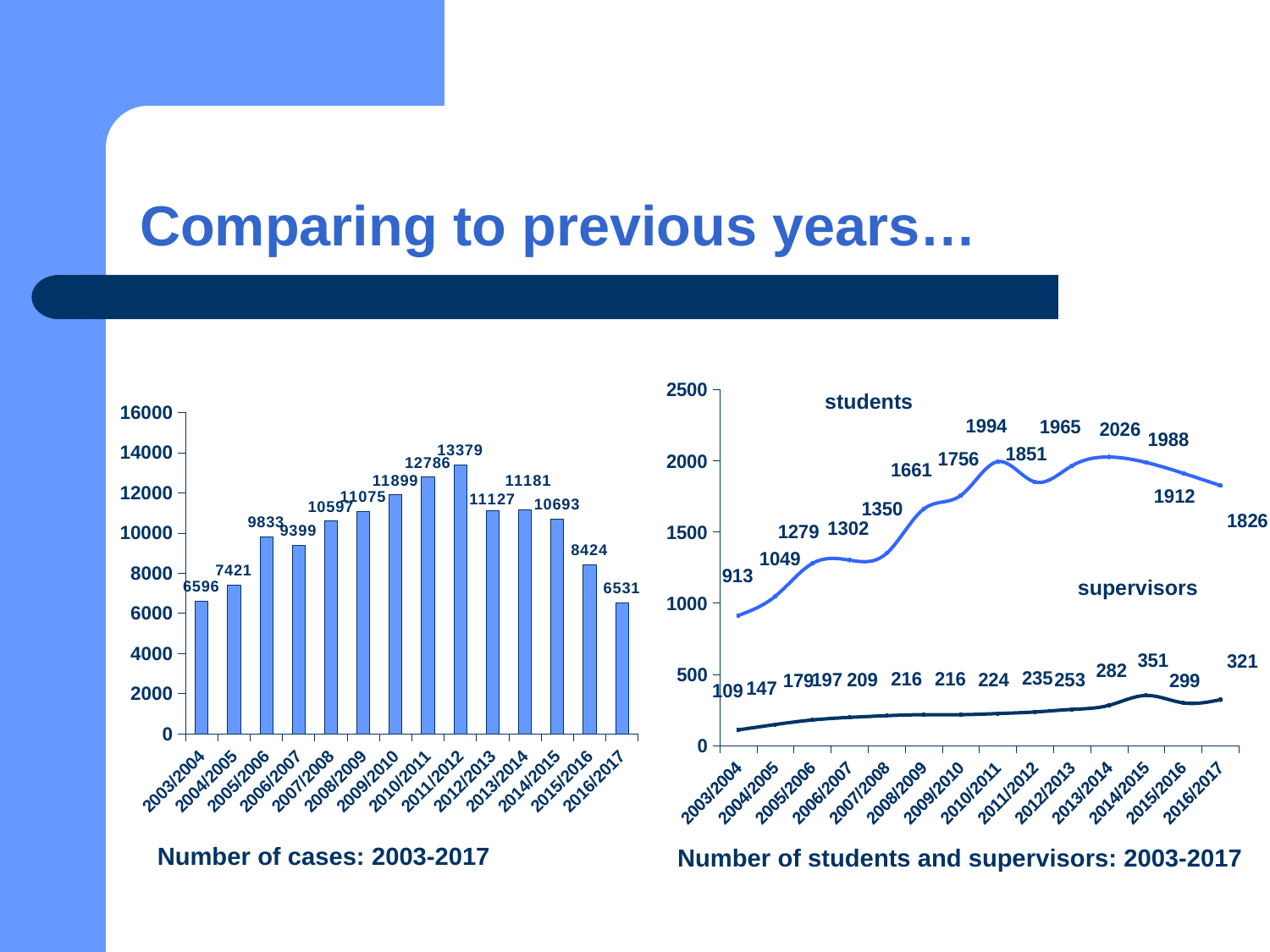
What kind of chart is 'Number of cases: 2003-2017'? Bar chart In the 'Number of students and supervisors: 2003-2017' chart, what is the number of students in 2013/2014? 2026 In the 'Number of students and supervisors: 2003-2017' chart, is the number of students in 2016/2017 larger or smaller than in 2015/2016? Smaller In the 'Number of students and supervisors: 2003-2017' chart, which year has the highest number of supervisors? 2014/2015 In the 'Number of cases: 2003-2017' chart, what is the difference between the values for 2010/2011 and 2009/2010? 887 In the 'Number of students and supervisors: 2003-2017' chart, what is the difference between the number of students and the number of supervisors in 2003/2004? 804 In the 'Number of cases: 2003-2017' chart, how many years are shown on the x axis? 14 In the 'Number of cases: 2003-2017' chart, which year has the highest number of cases? 2011/2012 In the 'Number of cases: 2003-2017' chart, which year has the lowest number of cases? 2016/2017 What kind of chart is 'Number of students and supervisors: 2003-2017'? Line chart In the 'Number of cases: 2003-2017' chart, what is the value for 2011/2012? 13379 In the 'Number of students and supervisors: 2003-2017' chart, what is the number of supervisors in 2014/2015? 351